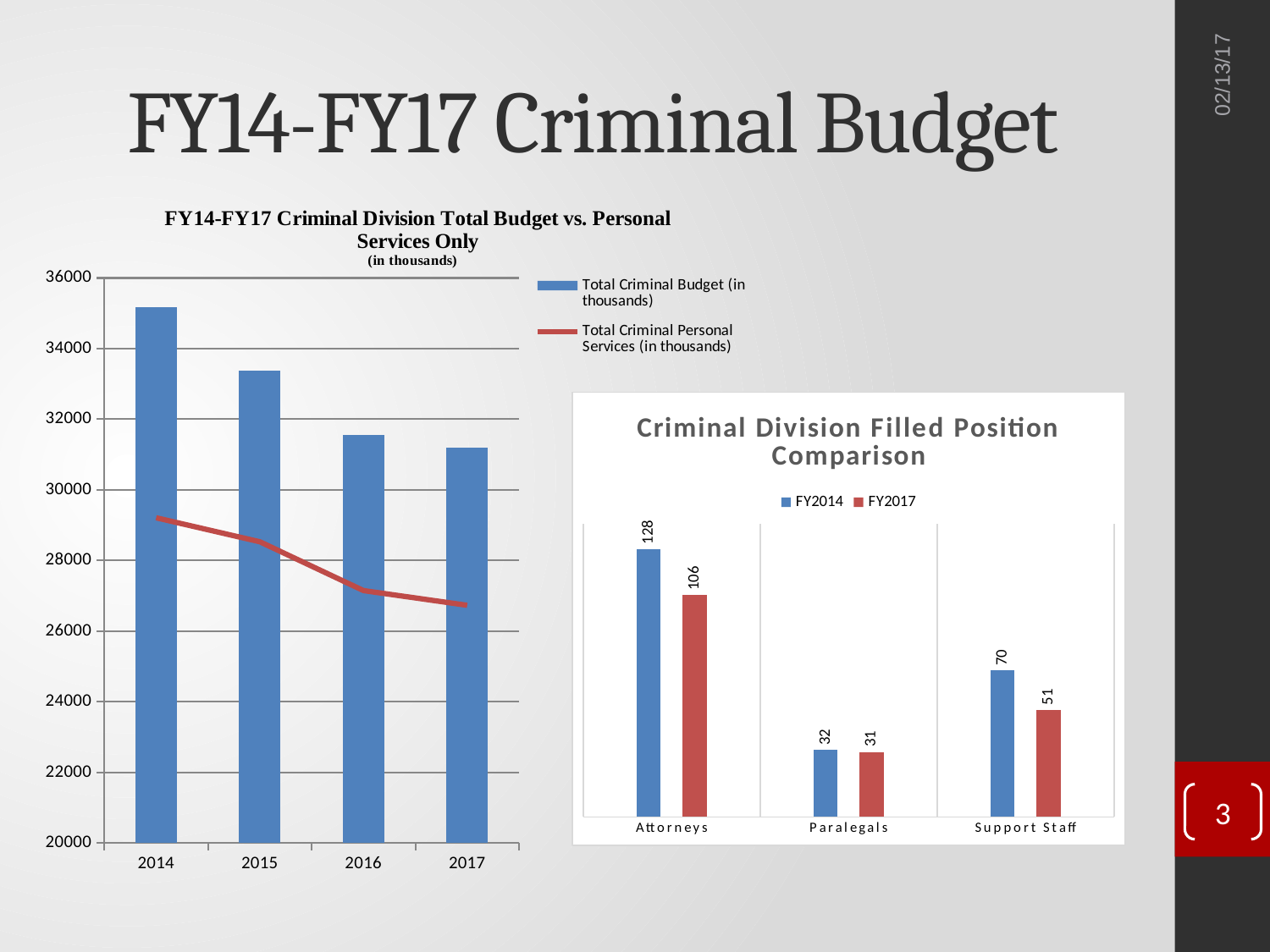
In the 'Criminal Division Filled Position Comparison' chart, what is the FY2017 value for Support Staff? 51 In the 'Criminal Division Filled Position Comparison' chart, what is the FY2017 value for Paralegals? 31 In the 'Criminal Division Filled Position Comparison' chart, what is the FY2014 value for Attorneys? 128 In the 'Criminal Division Filled Position Comparison' chart, what is the difference between the FY2014 and FY2017 values for Support Staff? 19 In the 'Criminal Division Filled Position Comparison' chart, which category has the lowest FY2017 value? Paralegals In the 'FY14-FY17 Criminal Division Total Budget vs. Personal Services Only' chart, is the Total Criminal Budget bar for 2014 greater or less than 34000? greater In the 'Criminal Division Filled Position Comparison' chart, what is the difference between the FY2014 and FY2017 values for Attorneys? 22 In the 'Criminal Division Filled Position Comparison' chart, which category has the highest FY2014 value? Attorneys In the 'FY14-FY17 Criminal Division Total Budget vs. Personal Services Only' chart, is the Total Criminal Personal Services value for 2017 greater or less than 28000? less In the 'Criminal Division Filled Position Comparison' chart, how many series does the legend list? 2 In the 'FY14-FY17 Criminal Division Total Budget vs. Personal Services Only' chart, how many years are shown on the x axis? 4 In the 'FY14-FY17 Criminal Division Total Budget vs. Personal Services Only' chart, do the Total Criminal Budget bars rise or fall from 2014 to 2017? fall